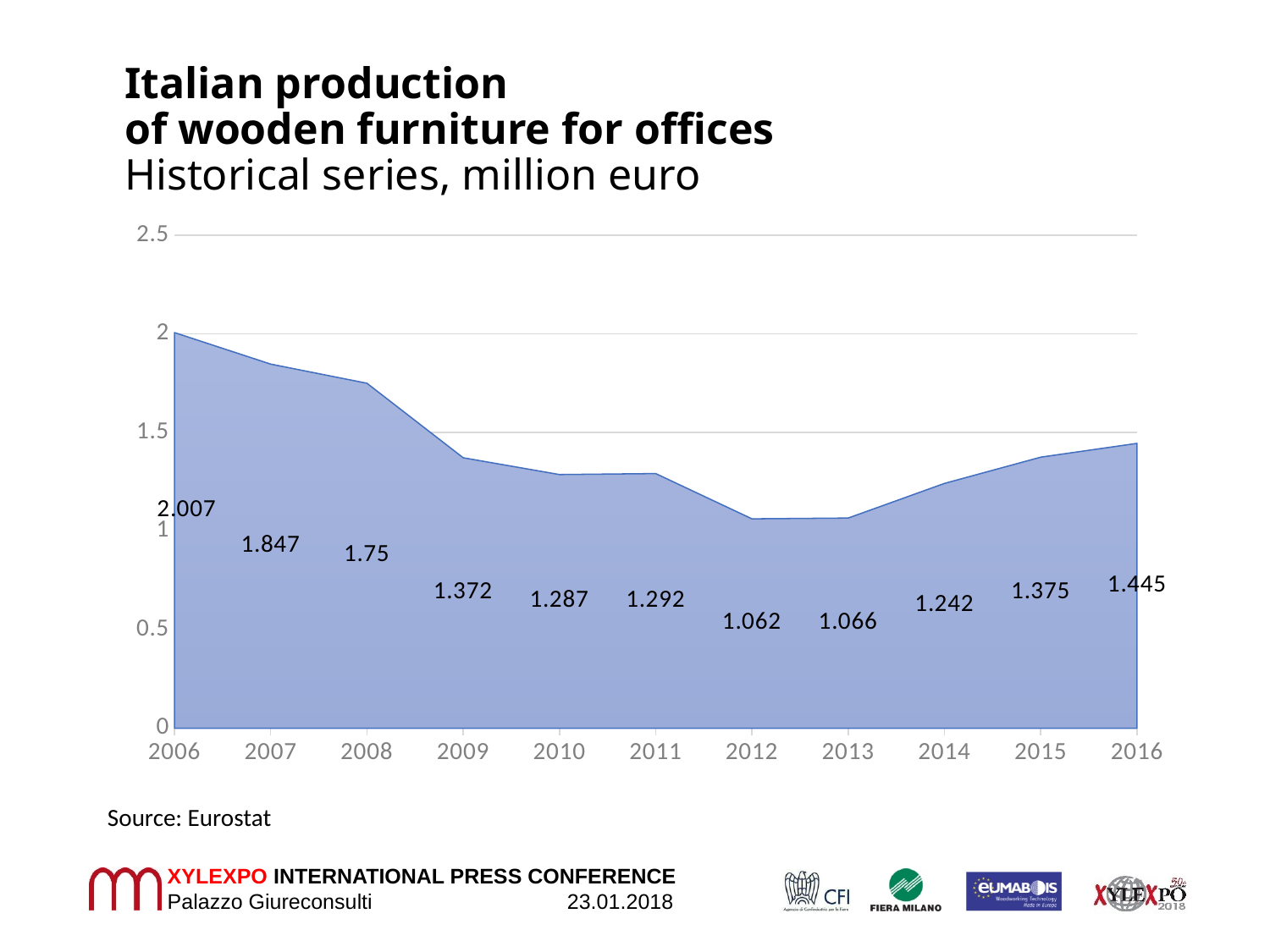
Which year has the lowest value in the chart? 2012 Is the value for 2008 greater or less than 1.5? greater What value is shown for 2012? 1.062 What value is shown for 2016? 1.445 Which year has the larger value, 2007 or 2014? 2007 What was the Italian production of wooden furniture for offices in 2006? 2.007 What is the difference between the values for 2006 and 2016? 0.562 What is the difference between the values for 2008 and 2009? 0.378 How many years are shown on the x axis? 11 Which year has the highest value in the chart? 2006 What type of chart is shown on the slide? Area chart What is the source cited for the chart data? Eurostat